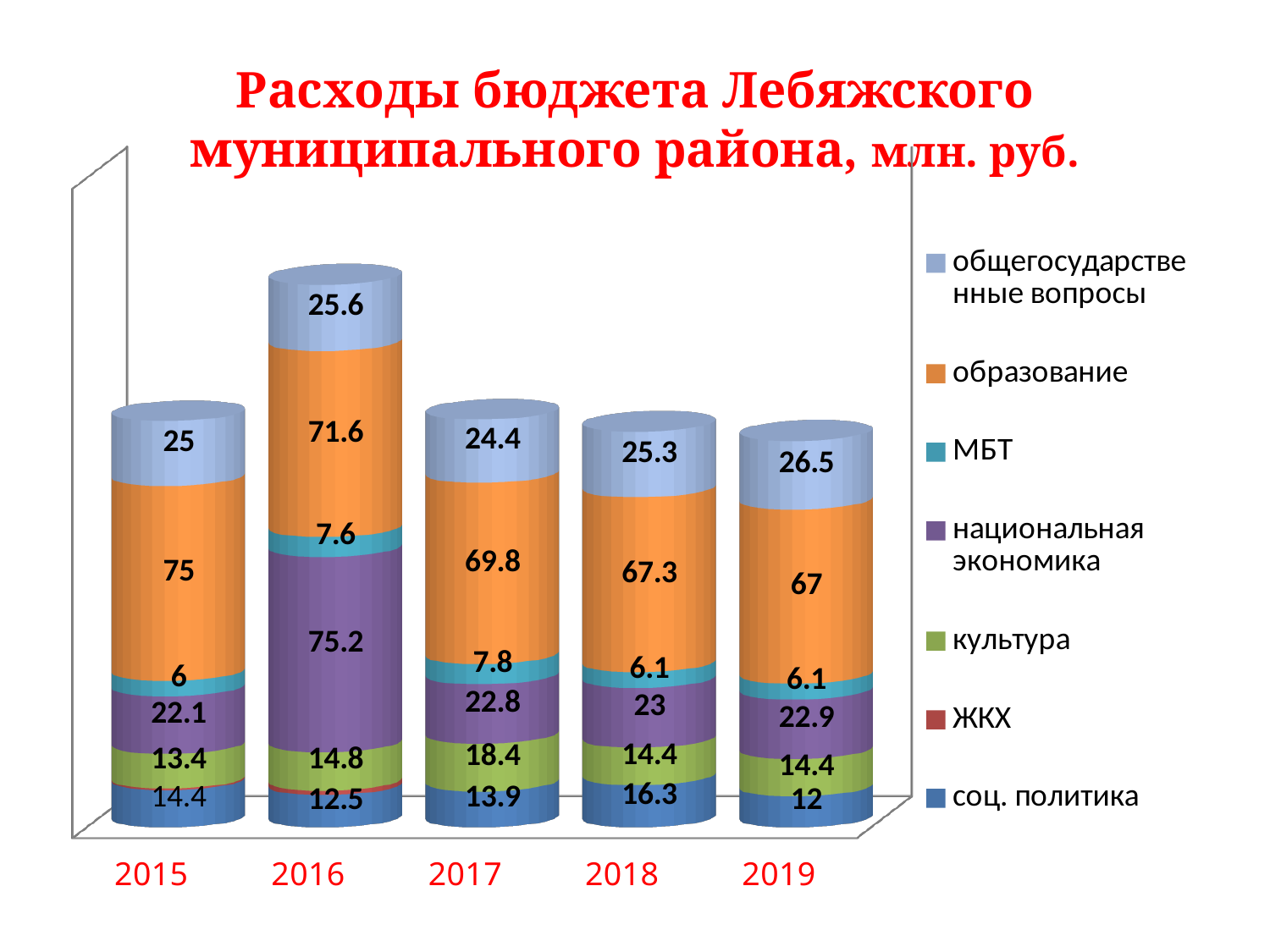
What is the value for МБТ in 2015? 6 What is the value for национальная экономика in 2016? 75.2 Which year has the larger value for соц. политика, 2015 or 2018? 2018 What is the difference between the культура values for 2017 and 2015? 5 How many series does the legend list? 7 What is the difference between the образование values for 2015 and 2019? 8 What is the value for соц. политика in 2018? 16.3 In which year is the value for образование the highest? 2015 How many years are shown on the x axis? 5 What is the value for общегосударственные вопросы in 2019? 26.5 What is the value for образование in 2016? 71.6 In which year is the value for соц. политика the lowest? 2019